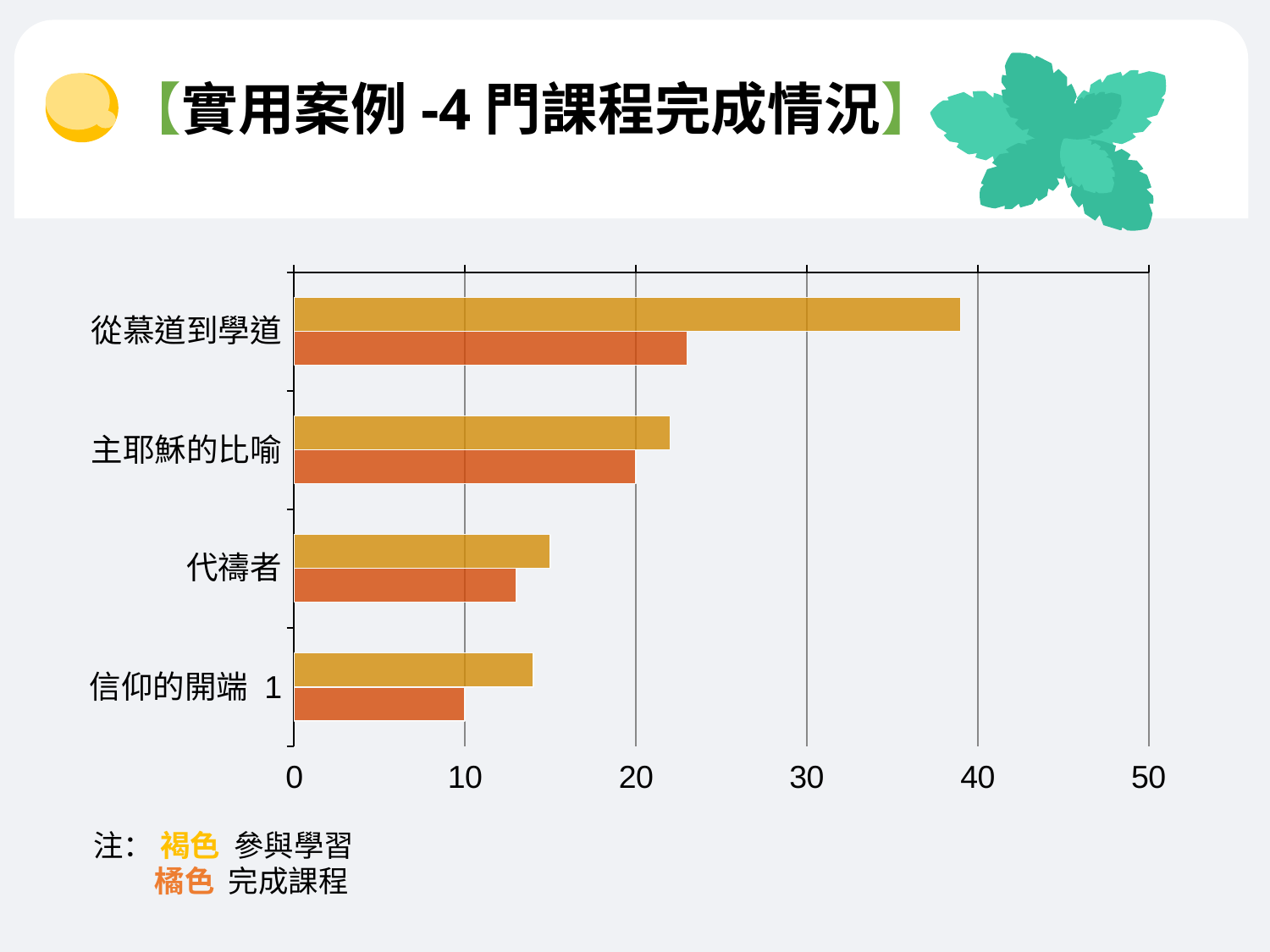
Is the 完成課程 (orange) value for 從慕道到學道 greater or less than 20? greater How many courses (categories) are shown on the chart? 4 According to the note on the slide, what does the orange colour (橘色) represent? 完成課程 Which course has the highest 參與學習 (brown) value? 從慕道到學道 What kind of chart is shown on the slide? bar chart For 從慕道到學道, which is larger: the 參與學習 (brown) value or the 完成課程 (orange) value? 參與學習 (brown) Is the 參與學習 (brown) value for 代禱者 greater or less than 20? less How many series does the chart's note (legend) describe? 2 What is the 完成課程 (orange) value for 信仰的開端 1? 10 Is the 參與學習 (brown) value for 從慕道到學道 greater or less than 30? greater Which course has the lowest 完成課程 (orange) value? 信仰的開端 1 What is the 完成課程 (orange) value for 主耶穌的比喻? 20